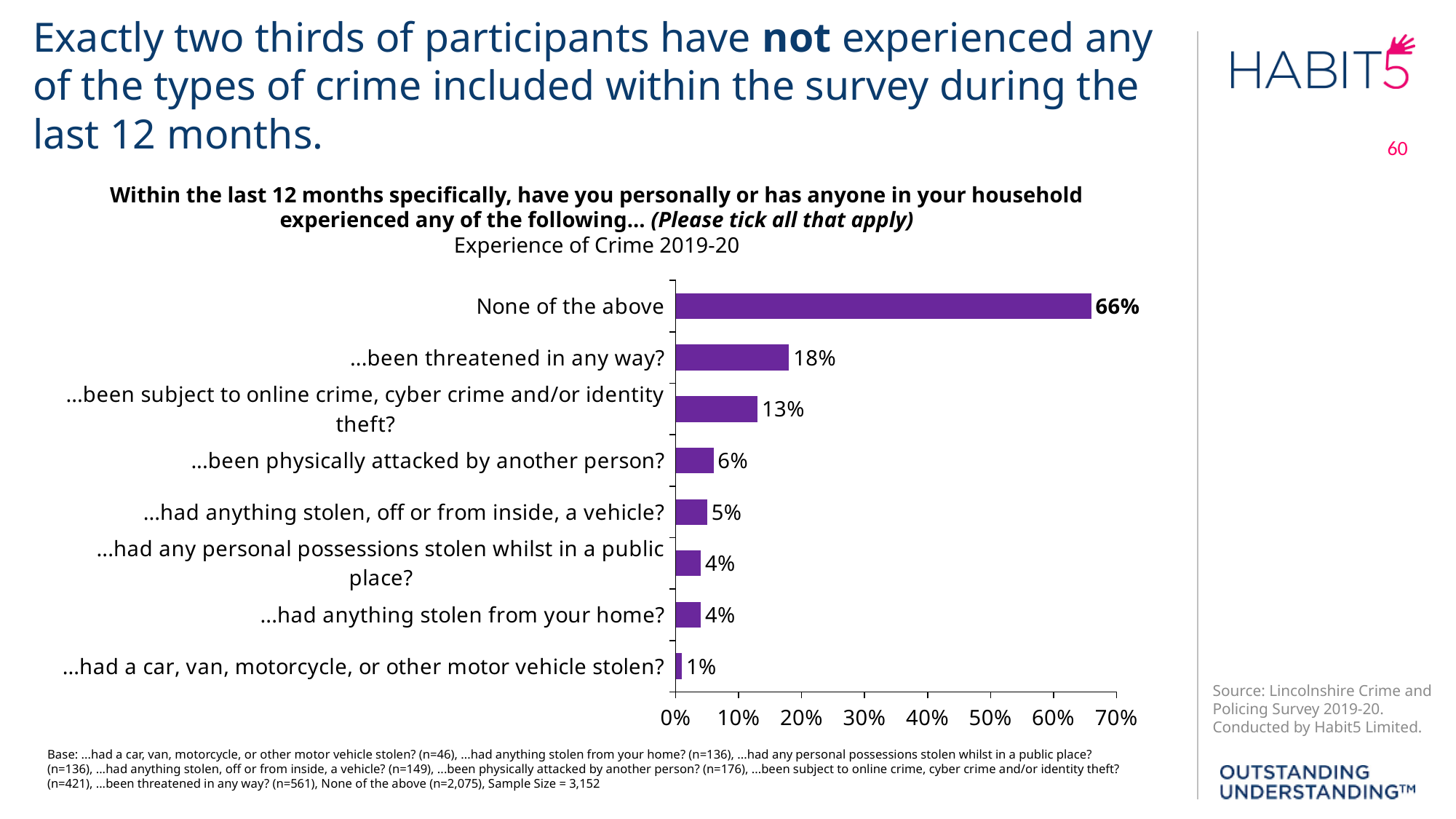
How many categories are shown in the chart? 8 What type of chart is shown on the slide? Bar chart What percentage of participants reported having been threatened in any way? 18% What percentage of participants reported having had a car, van, motorcycle, or other motor vehicle stolen? 1% Which category has the highest value in the chart? None of the above What is the difference in percentage points between "been threatened in any way" and "been subject to online crime, cyber crime and/or identity theft"? 5 What is the title of the chart? Experience of Crime 2019-20 Which is larger: the value for "been physically attacked by another person" or the value for "had anything stolen, off or from inside, a vehicle"? ...been physically attacked by another person? Which category has the lowest value in the chart? ...had a car, van, motorcycle, or other motor vehicle stolen? What percentage of participants reported having been subject to online crime, cyber crime and/or identity theft? 13% What percentage of participants selected "None of the above"? 66% Is the value for "None of the above" greater or less than 60%? greater